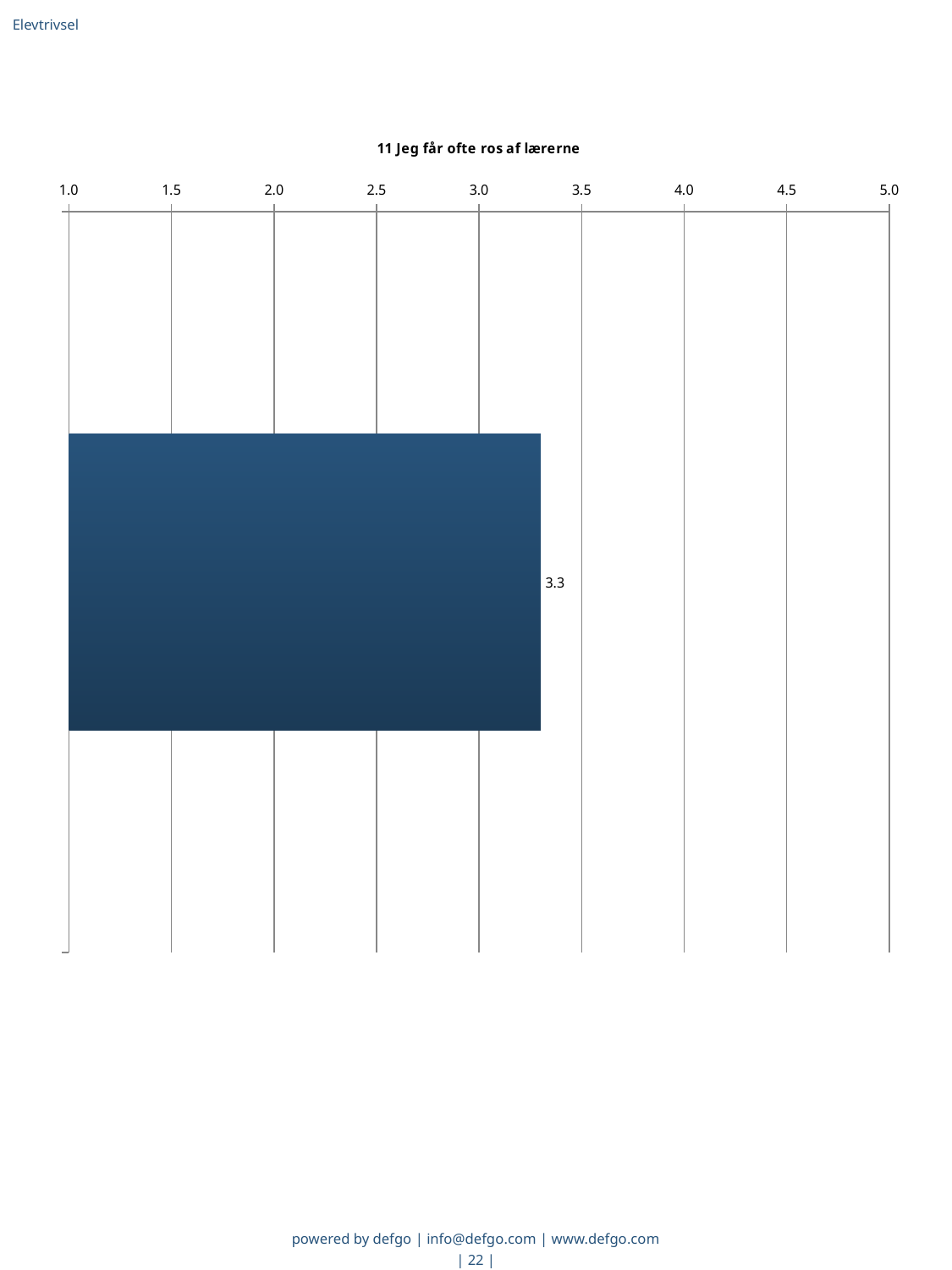
Is the value of the bar greater or less than 3.5? less Is the bar in the chart horizontal or vertical? horizontal How many bars are plotted in the chart? 1 What is the maximum value shown on the chart's axis? 5.0 Is the value of the bar greater or less than 3.0? greater What is the value shown on the bar in the chart titled "11 Jeg får ofte ros af lærerne"? 3.3 What is the title of the chart? 11 Jeg får ofte ros af lærerne What kind of chart is shown on the slide? bar chart